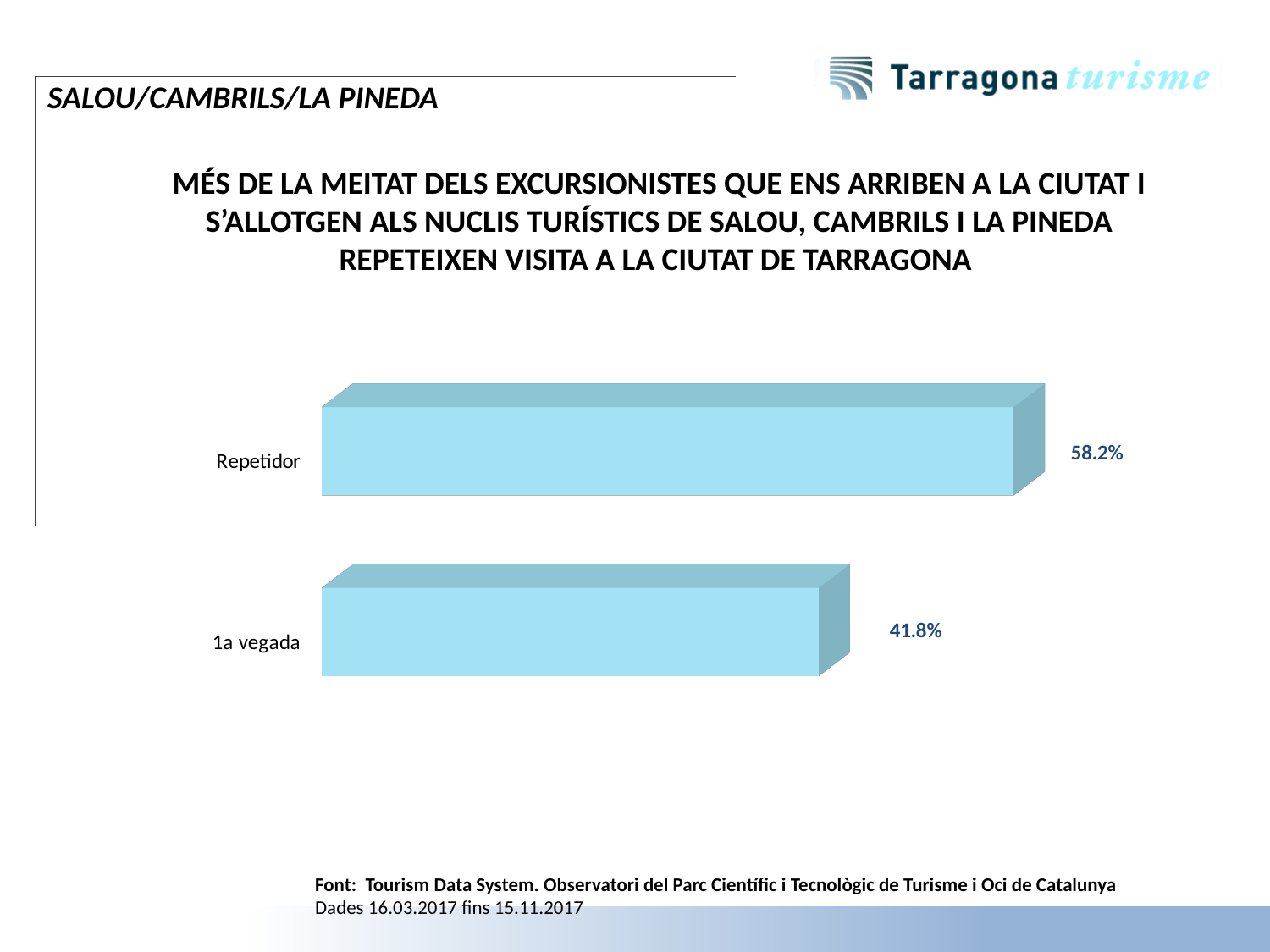
What is the value for 1a vegada? 41.8% How many categories are shown in the chart? 2 Are the bars in the chart horizontal or vertical? Horizontal What is the total of the two values shown in the chart? 100% What colour are the bars in the chart? Light blue What is the value for Repetidor? 58.2% Which category has the highest value? Repetidor What kind of chart is shown on the slide? Bar chart What is the difference between the values for Repetidor and 1a vegada? 16.4% Which category has the lowest value? 1a vegada Which is larger, the value for Repetidor or the value for 1a vegada? Repetidor